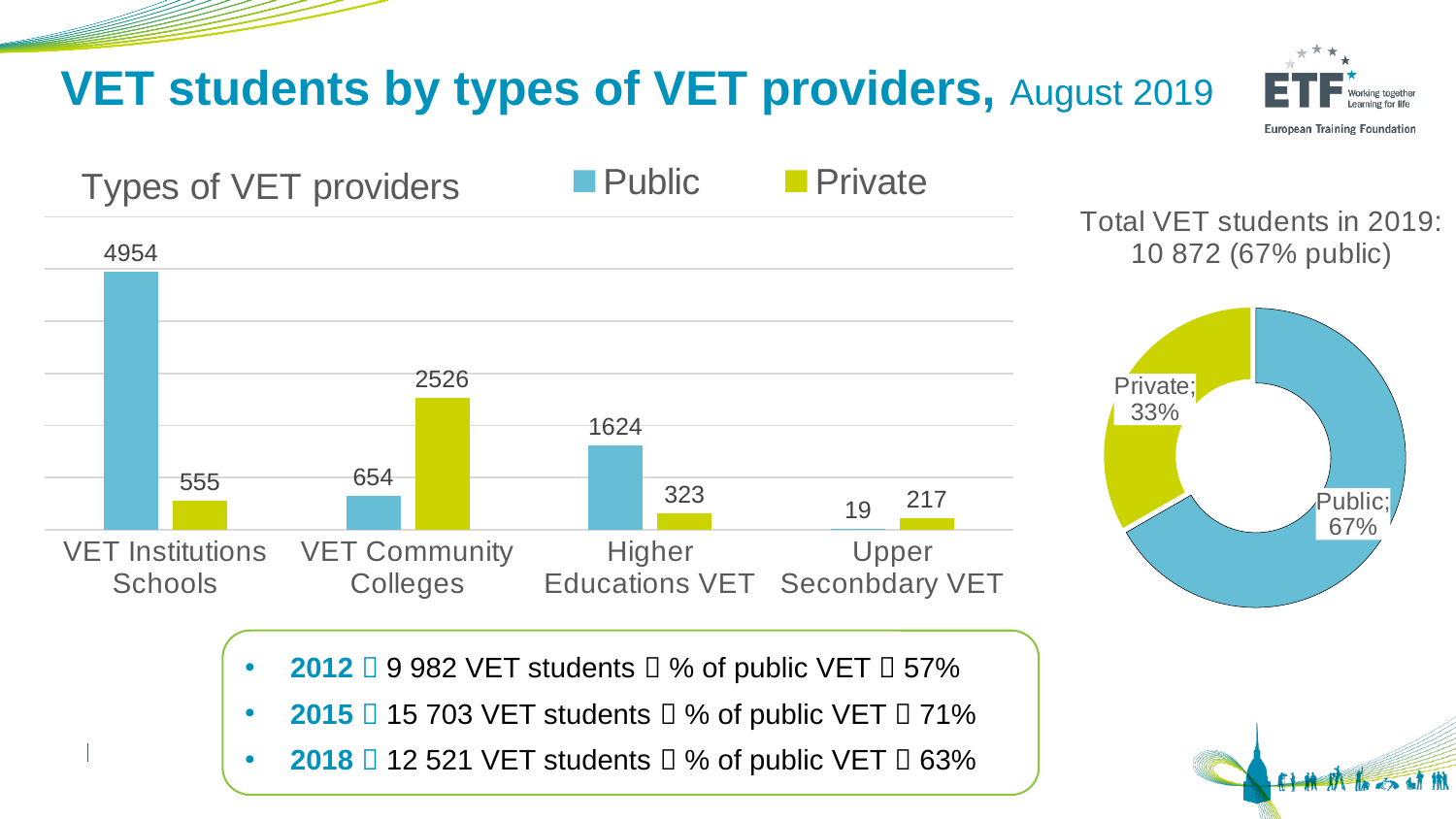
In the 'Types of VET providers' bar chart, which category has the lowest Public value? Upper Seconbdary VET How many series does the legend of the 'Types of VET providers' bar chart list? 2 In the 'Total VET students in 2019' doughnut chart, what share is Private? 33% In the 'Types of VET providers' bar chart, what is the Public value for VET Institutions Schools? 4954 In the 'Types of VET providers' bar chart, what is the difference between the Public and Private values for VET Institutions Schools? 4399 How many categories are shown on the x axis of the 'Types of VET providers' bar chart? 4 In the 'Types of VET providers' bar chart, what is the Private value for Upper Seconbdary VET? 217 In the 'Types of VET providers' bar chart, what is the Public value for Higher Educations VET? 1624 In the 'Types of VET providers' bar chart, which is larger for VET Community Colleges, the Public or the Private value? Private In the 'Types of VET providers' bar chart, which category has the highest Public value? VET Institutions Schools What kind of chart is the 'Types of VET providers' chart? Bar chart In the 'Types of VET providers' bar chart, what is the Private value for VET Community Colleges? 2526